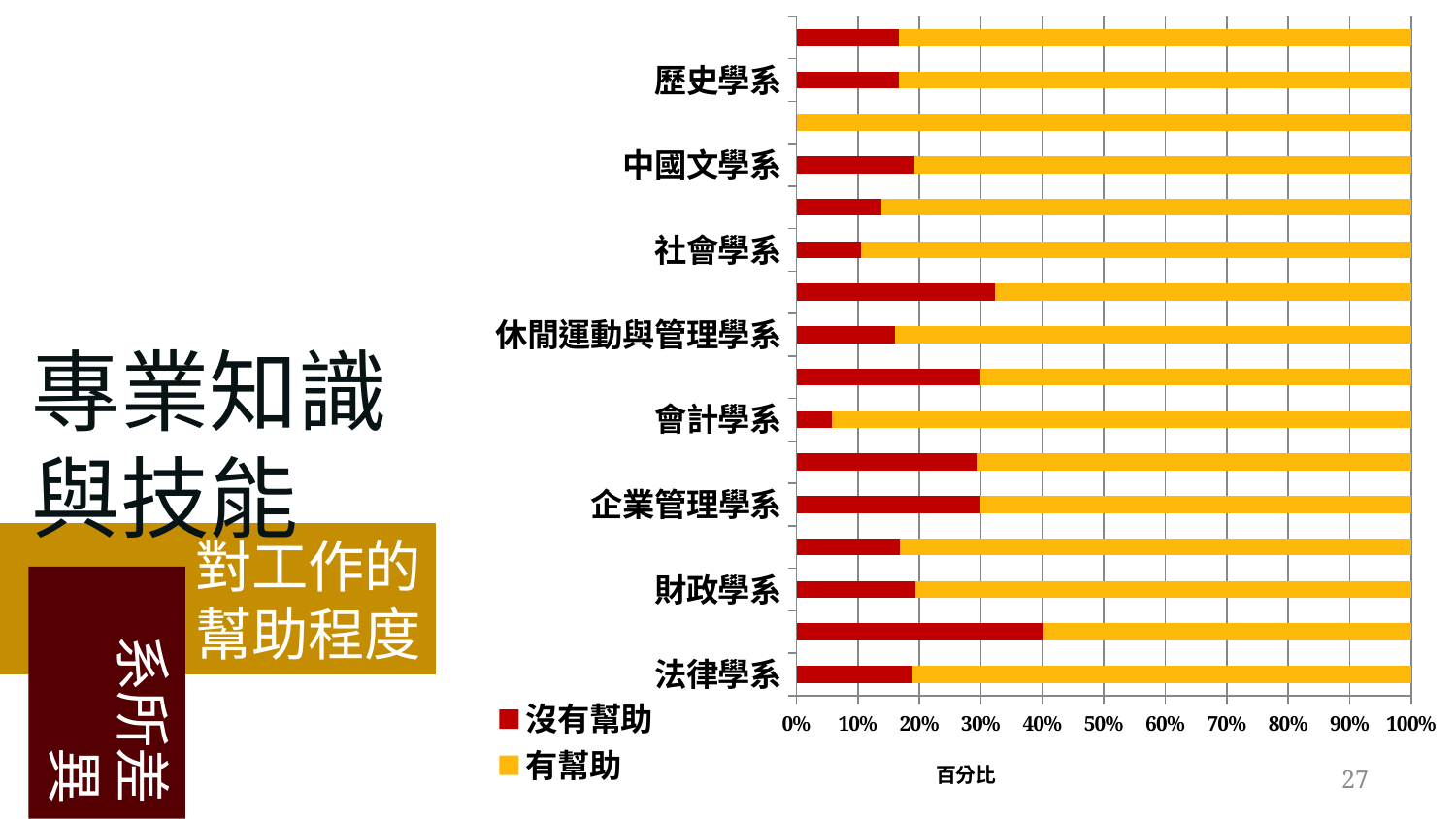
What is the title of the horizontal axis of the chart? 百分比 What does each stacked bar in the chart add up to? 100% What kind of chart is shown on the slide? stacked bar chart Is the 有幫助 value for 會計學系 greater or less than 90%? greater What are the two legend entries of the chart? 沒有幫助, 有幫助 How many series does the chart legend list? 2 Which has the larger 沒有幫助 share, 會計學系 or 企業管理學系? 企業管理學系 Is the 沒有幫助 value for 企業管理學系 greater or less than 20%? greater Is the 沒有幫助 value for 會計學系 greater or less than 10%? less How many department labels are shown on the vertical axis of the chart? 8 Among the labeled departments, which has the smallest 沒有幫助 share? 會計學系